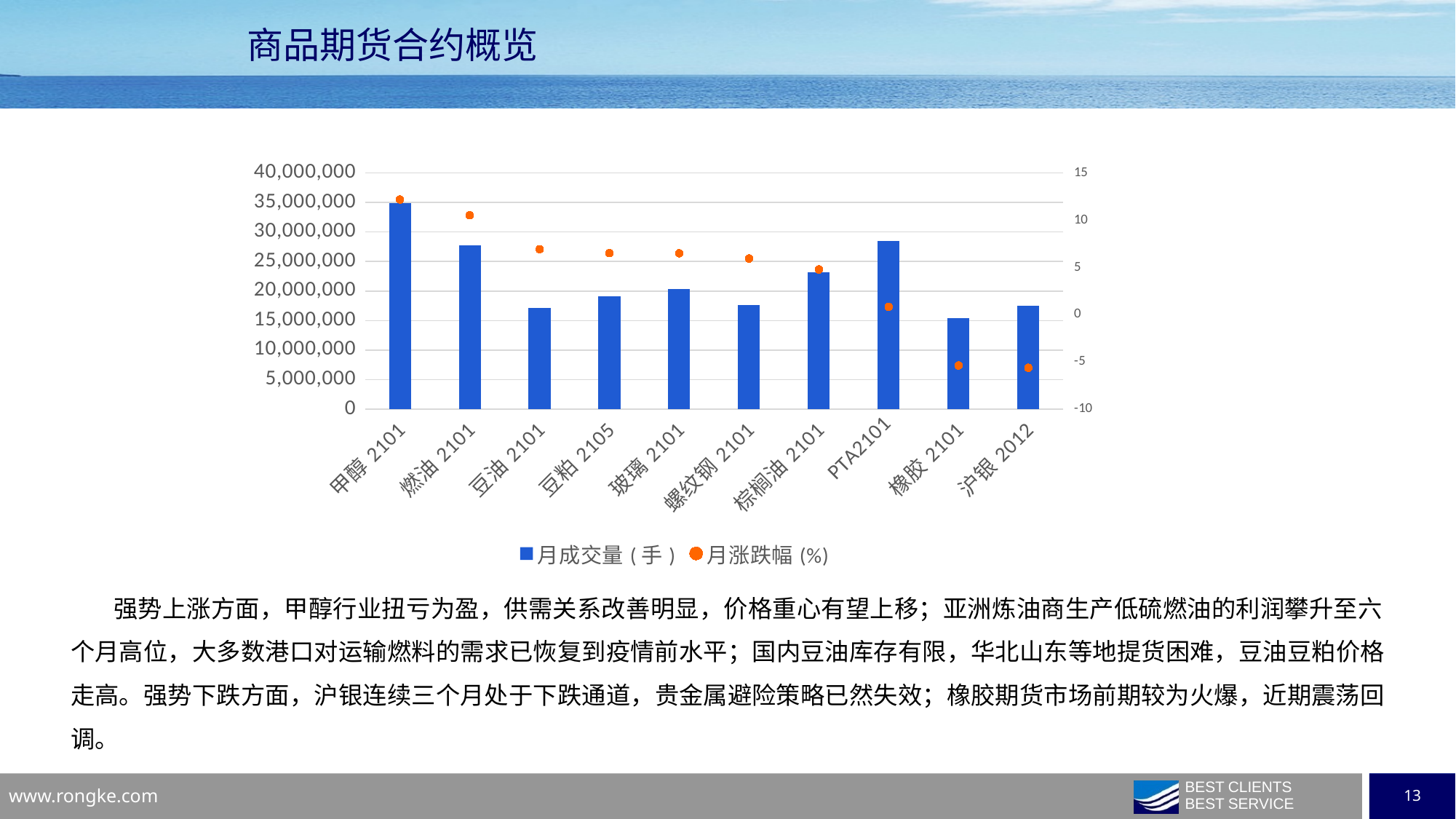
Which has the larger 月成交量（手） bar, 棕榈油 2101 or 玻璃 2101? 棕榈油 2101 Is the 月成交量（手） bar for 橡胶 2101 greater or less than 20,000,000? less What kind of chart is shown on the slide? A bar chart (with a dot series plotted on a secondary axis) Which contract has the highest 月成交量（手） bar? 甲醇 2101 Which contract has the lowest 月成交量（手） bar? 橡胶 2101 Which contract has the highest 月涨跌幅 (%) dot? 甲醇 2101 Is the 月成交量（手） bar for 甲醇 2101 greater or less than 30,000,000? greater Which has the larger 月成交量（手） bar, 甲醇 2101 or 燃油 2101? 甲醇 2101 How many contracts (categories) are shown on the x axis of the chart? 10 Is the 月涨跌幅 (%) dot for 沪银 2012 greater or less than 0? less How many series does the chart legend list? 2